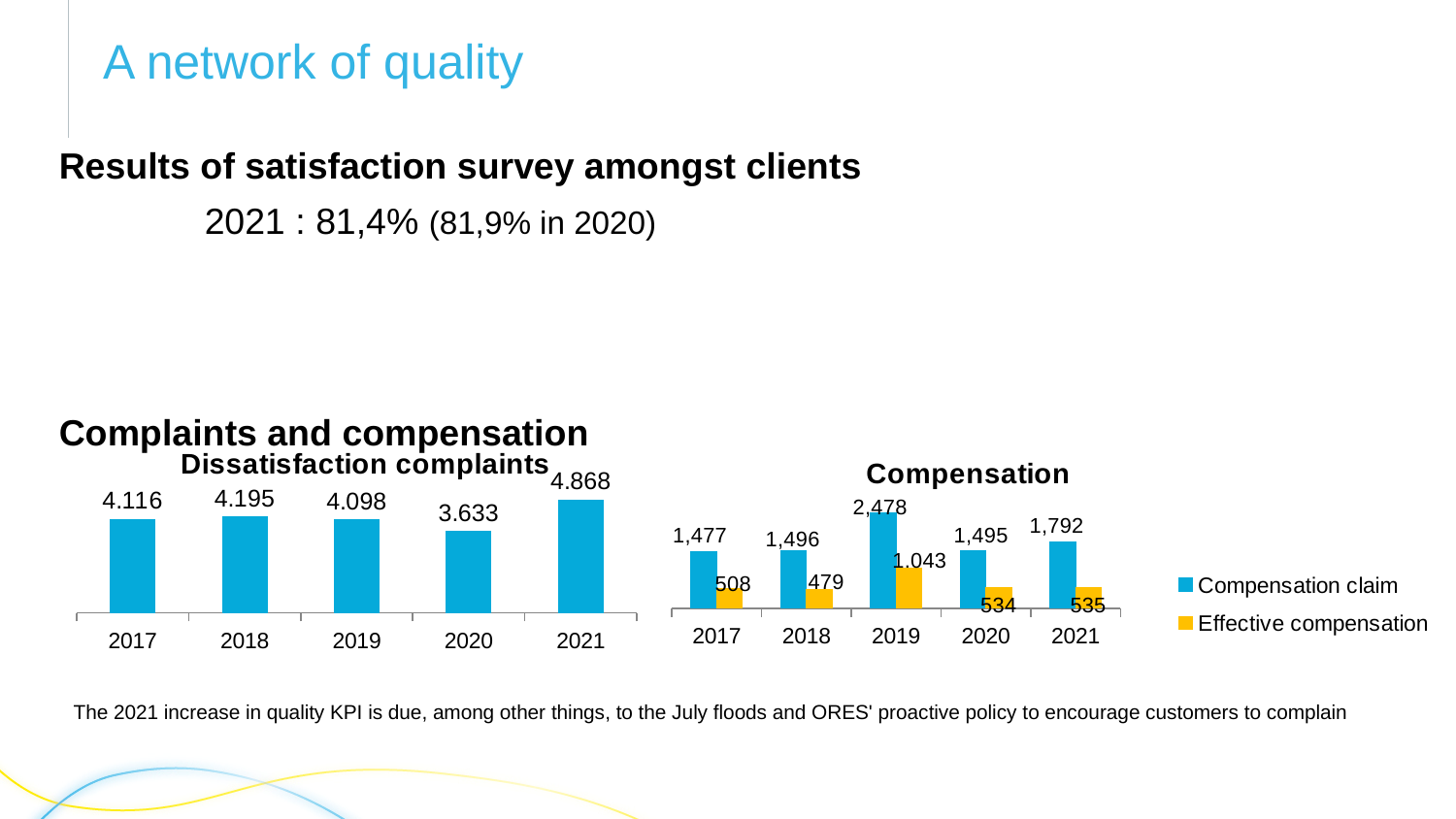
In the Compensation chart, which year has the highest Compensation claim value? 2019 In the Compensation chart, what is the Compensation claim value for 2019? 2,478 How many series does the legend of the Compensation chart list? 2 In the Dissatisfaction complaints chart, which year has the highest value? 2021 In the Dissatisfaction complaints chart, what is the value for 2021? 4.868 In the Compensation chart, what is the Effective compensation value for 2018? 479 In the Dissatisfaction complaints chart, which year has the lowest value? 2020 What type of chart is the Compensation chart? Bar chart In the Dissatisfaction complaints chart, which is larger, the value for 2018 or the value for 2019? 2018 In the Compensation chart, which year has the lowest Effective compensation value? 2018 In the Compensation chart, what is the difference between the Compensation claim and the Effective compensation in 2021? 1,257 How many years are shown in the Dissatisfaction complaints chart? 5